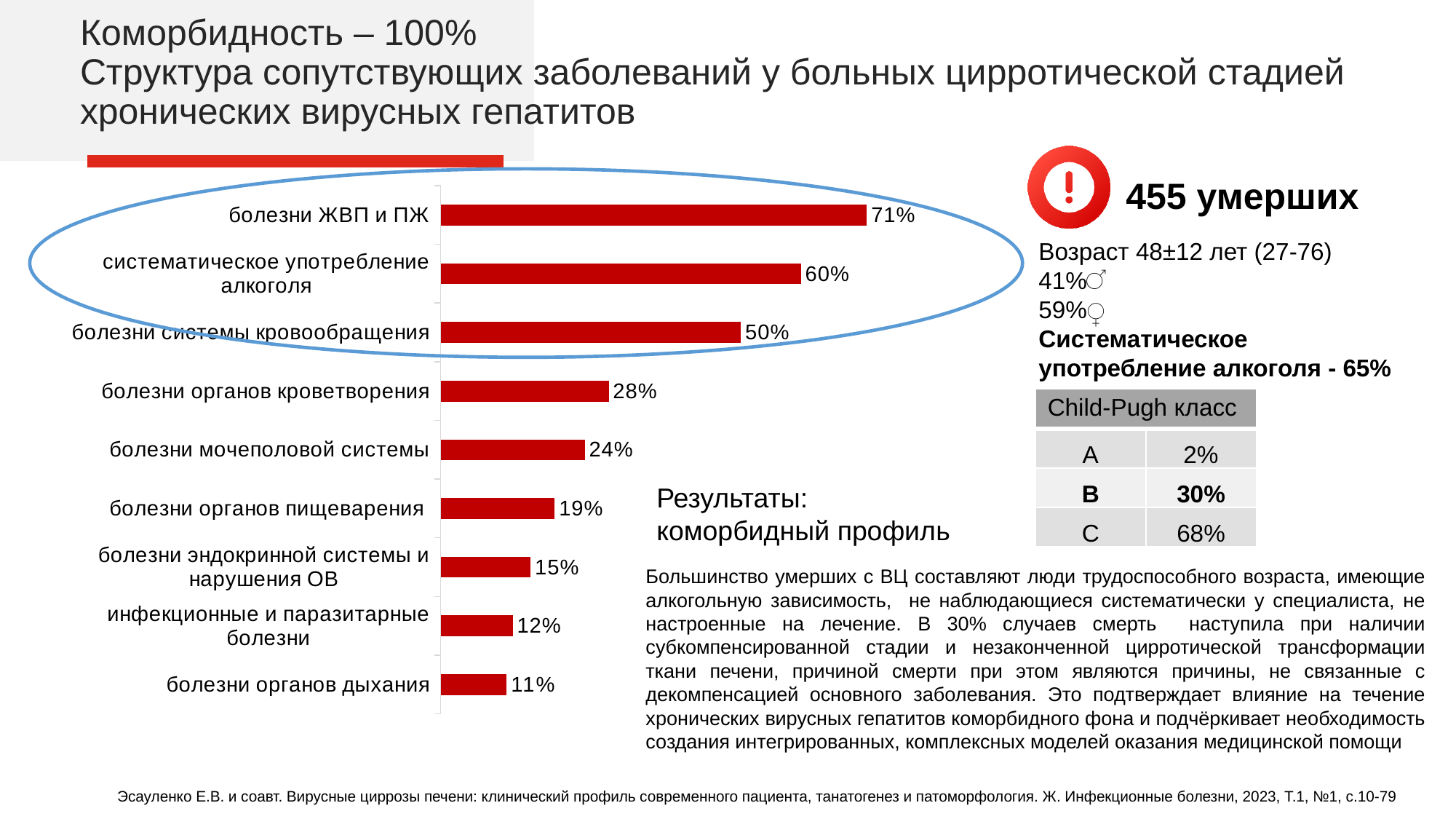
What is the value for инфекционные и паразитарные болезни? 12% What is the difference between the values for болезни ЖВП и ПЖ and болезни органов дыхания? 60% What is the value for болезни органов кроветворения? 28% How many categories are shown in the bar chart? 9 What kind of chart is shown on the slide? bar chart Which category has the lowest value? болезни органов дыхания What colour are the bars in the chart? red Which category has the highest value? болезни ЖВП и ПЖ What is the value for болезни органов дыхания? 11% What is the value for болезни ЖВП и ПЖ? 71% Which is larger: the value for болезни мочеполовой системы or the value for болезни органов пищеварения? болезни мочеполовой системы What is the difference between the values for систематическое употребление алкоголя and болезни системы кровообращения? 10%